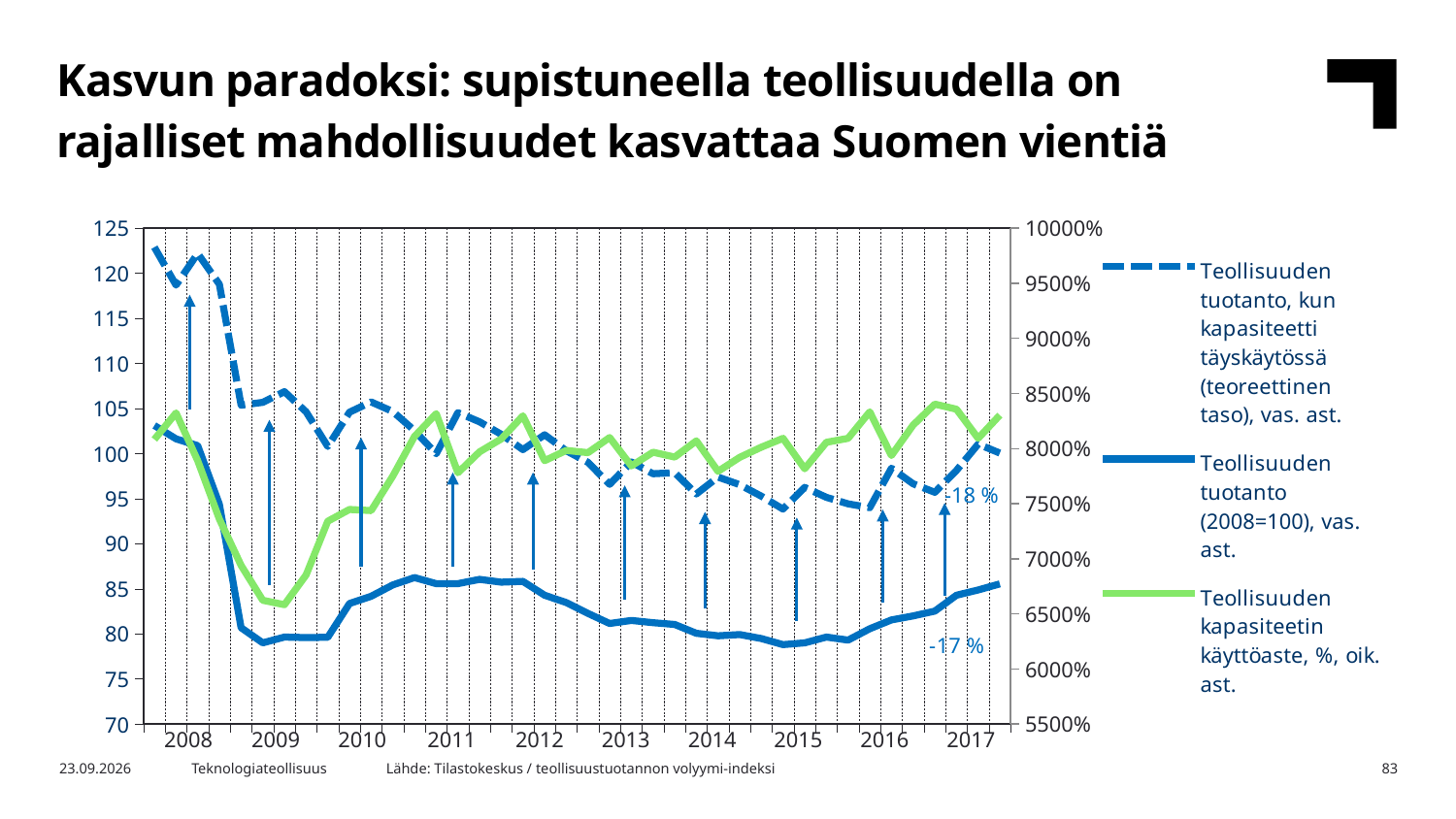
Is the value of the solid blue line (Teollisuuden tuotanto) in 2009 greater or less than 85? less Which series is drawn as a dashed line? Teollisuuden tuotanto, kun kapasiteetti täyskäytössä (teoreettinen taso), vas. ast. How many years are labelled on the x axis? 10 In which year does the dashed line reach its highest value? 2008 Does the solid blue line (Teollisuuden tuotanto, 2008=100) rise or fall from 2008 to 2009? fall Which series is plotted on the right axis (oik. ast.)? Teollisuuden kapasiteetin käyttöaste, %, oik. ast. What kind of chart is shown on the slide? line chart Is the value of the dashed line at the start of 2008 greater or less than 115? greater In 2009, which is higher: the dashed line (teoreettinen taso) or the solid blue line (Teollisuuden tuotanto)? the dashed line How many series does the legend list? 3 What percentage change is annotated next to the solid blue line at the right end of the chart? -17 % Is the value of the solid blue line (Teollisuuden tuotanto) in 2017 greater or less than 90? less